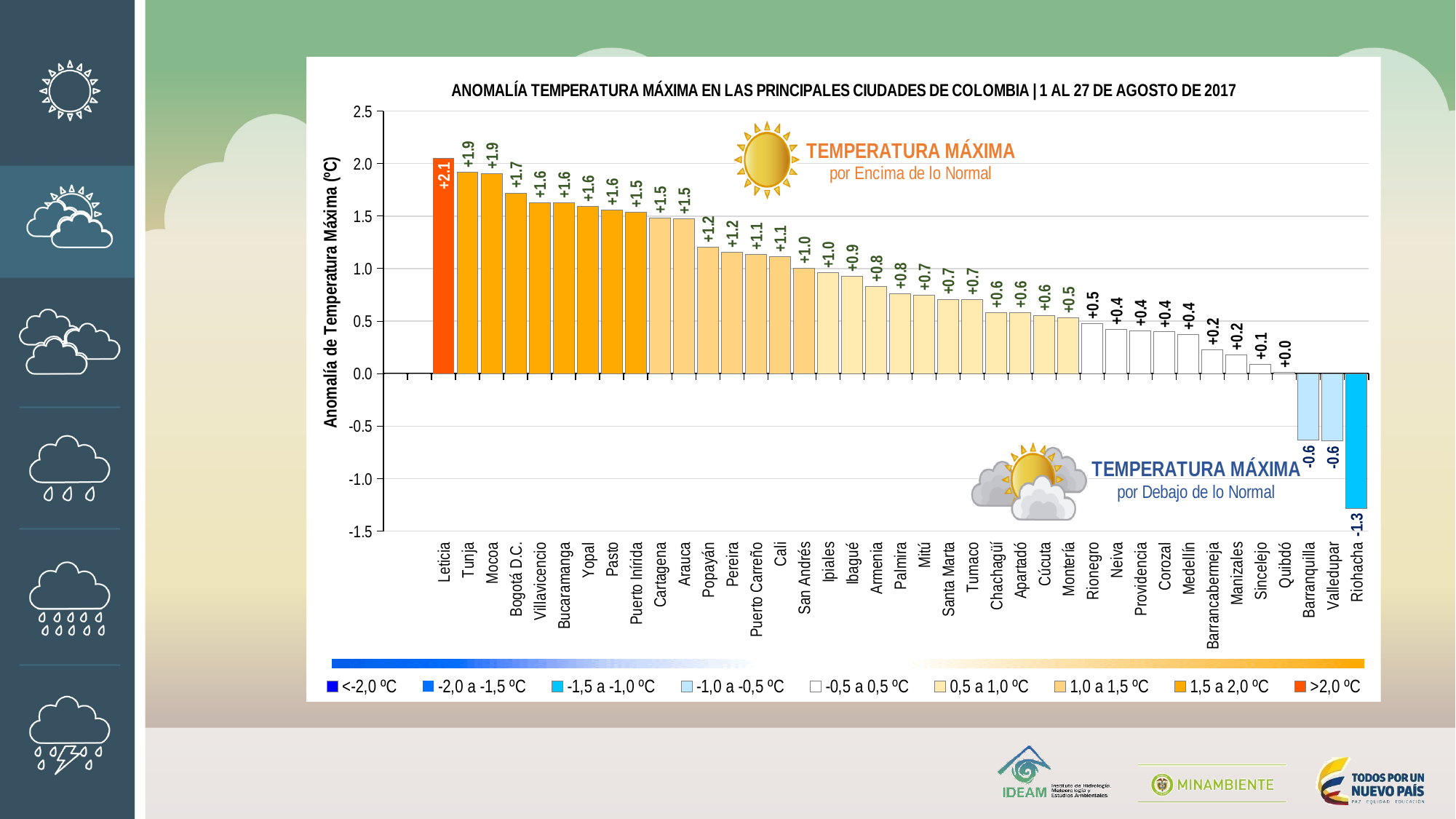
What is the value shown for Bogotá D.C.? +1.7 Which has a larger anomaly, Bogotá D.C. or Medellín? Bogotá D.C. What is the maximum temperature anomaly shown for Leticia? +2.1 What is the value shown for Riohacha? -1.3 Is the value for Tunja greater or less than 1.5? greater What kind of chart is shown on the slide? bar chart How many cities are plotted on the chart? 39 What is the value shown for Cali? +1.1 Do the values rise or fall from left to right along the x axis? fall What is the difference between the values for Leticia and Riohacha? 3.4 Which city has the lowest maximum temperature anomaly? Riohacha Which city has the highest maximum temperature anomaly? Leticia